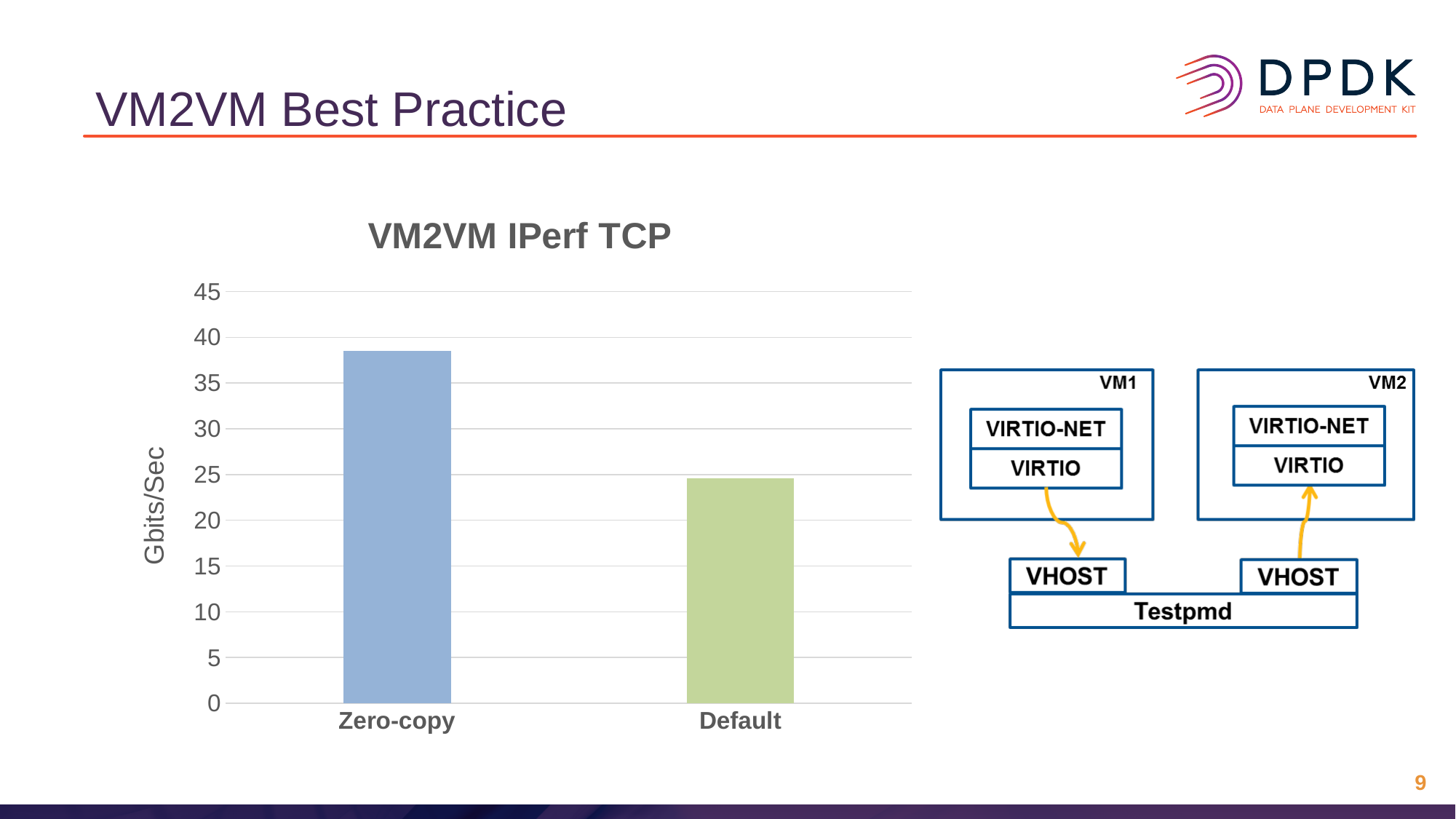
Which category has the highest value in the chart? Zero-copy Which is larger, the value for Zero-copy or the value for Default? Zero-copy Is the value for Default greater or less than 30? less What kind of chart is shown on the slide? bar chart What is the label of the vertical axis of the chart? Gbits/Sec Is the value for Zero-copy greater or less than 40? less What is the title of the chart? VM2VM IPerf TCP Which category has the lowest value in the chart? Default Is the value for Default greater or less than 20? greater How many categories are plotted in the chart? 2